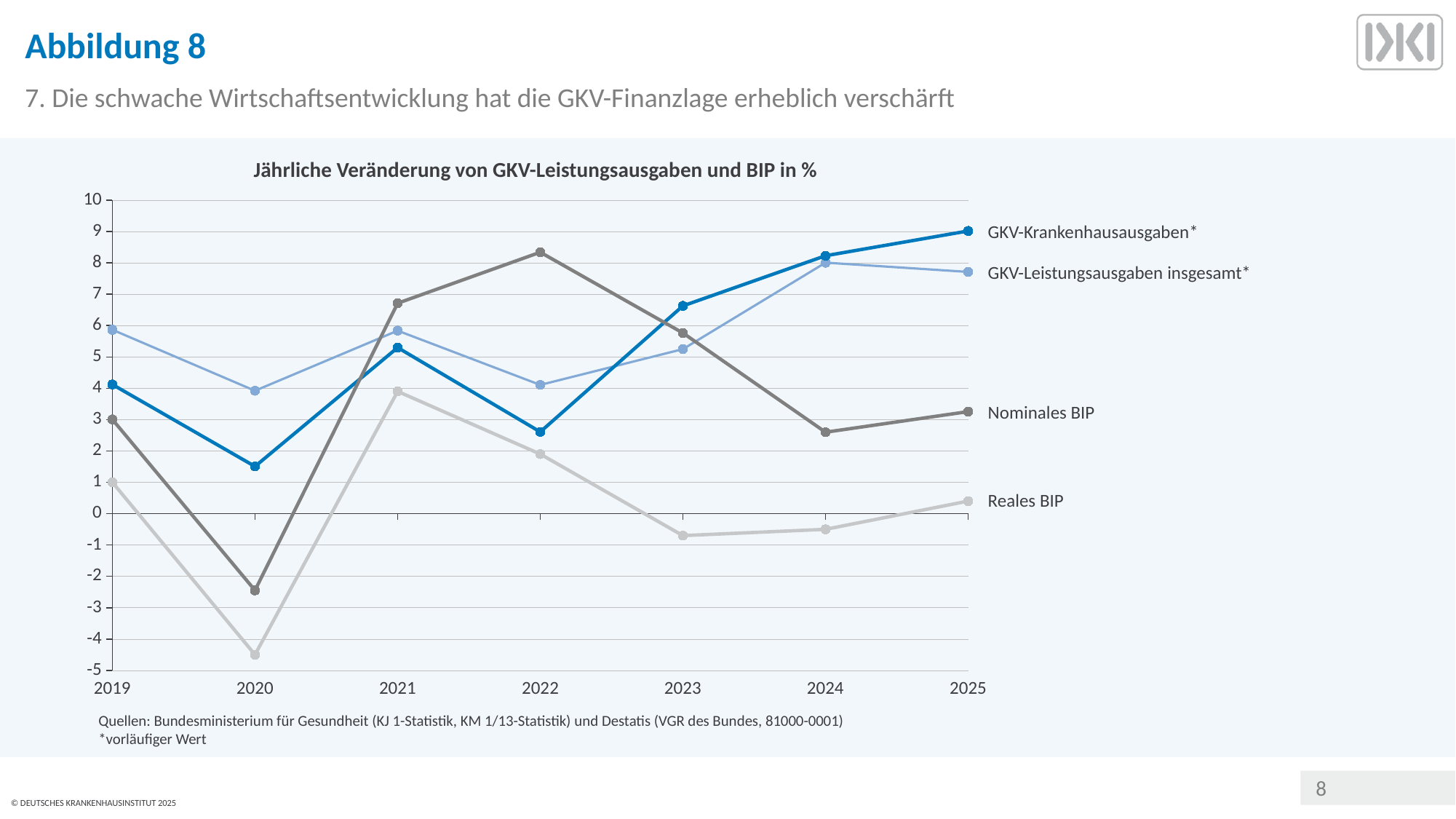
In which year does Nominales BIP reach its highest value? 2022 Does GKV-Krankenhausausgaben rise or fall from 2022 to 2025? rise How many years are shown on the x axis of the chart? 7 In which year does GKV-Krankenhausausgaben reach its highest value? 2025 What is the title of the chart? Jährliche Veränderung von GKV-Leistungsausgaben und BIP in % What kind of chart is shown on the slide? line chart Is the value for GKV-Krankenhausausgaben in 2025 greater or less than 8? greater Is the value for Nominales BIP in 2020 greater or less than -2? less Is the value for Reales BIP in 2020 greater or less than -4? less How many series are plotted in the chart? 4 In which year does Reales BIP reach its lowest value? 2020 In 2022, which is larger: Nominales BIP or GKV-Krankenhausausgaben? Nominales BIP